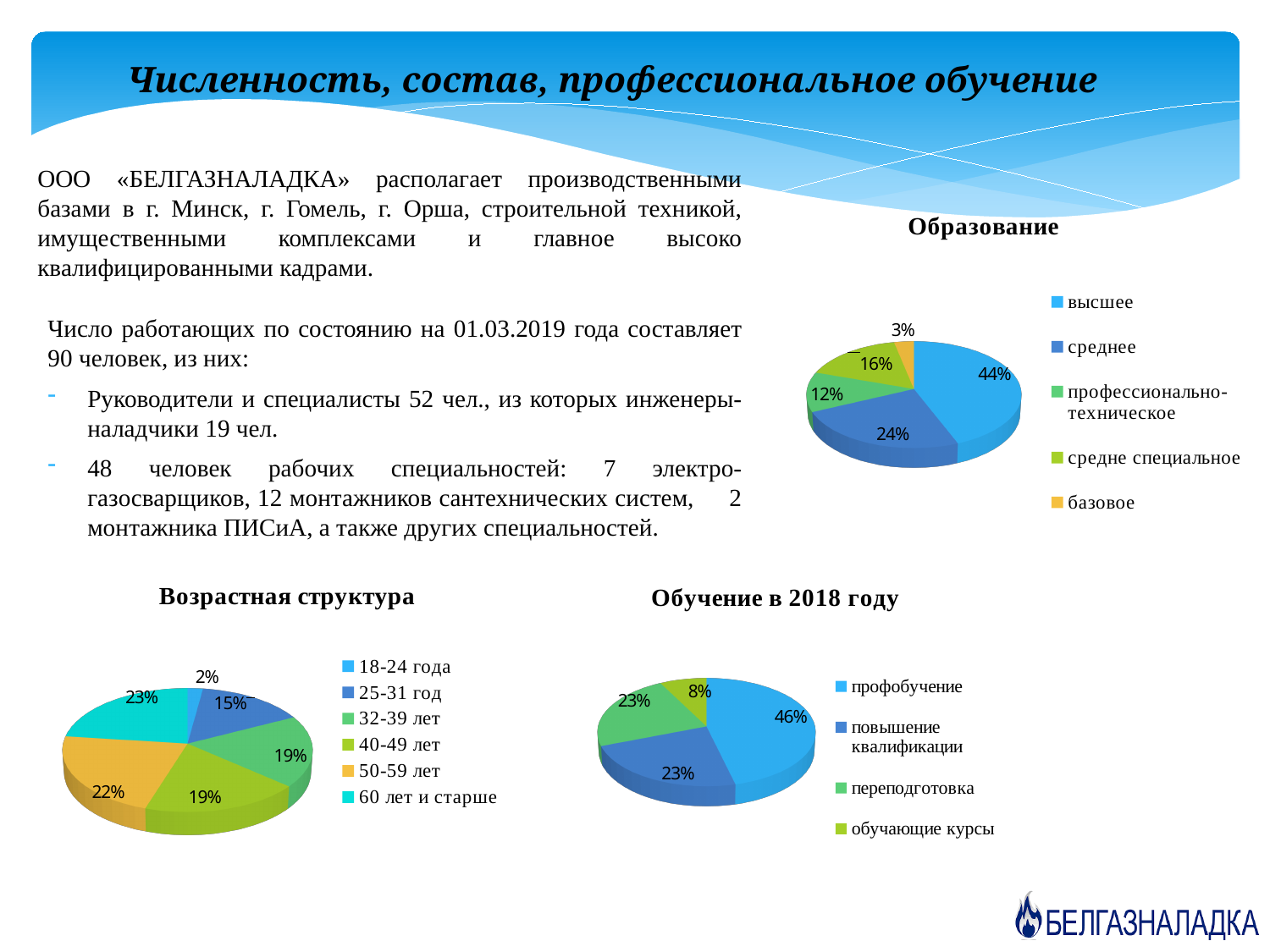
How many age groups are shown on the 'Возрастная структура' chart? 6 How many entries does the legend of the 'Образование' chart list? 5 On the 'Образование' chart, what is the difference between the 'среднее' share and the 'профессионально-техническое' share? 12% On the 'Возрастная структура' chart, what share is labelled for '50-59 лет'? 22% What kind of chart is 'Возрастная структура'? pie chart On the 'Образование' chart, what share is labelled for 'высшее'? 44% On the 'Образование' chart, which category has the smallest share? базовое On the 'Обучение в 2018 году' chart, what share is labelled for 'профобучение'? 46% On the 'Возрастная структура' chart, which age group has the largest share? 60 лет и старше On the 'Возрастная структура' chart, which age group has the smallest share? 18-24 года On the 'Обучение в 2018 году' chart, which is larger: 'повышение квалификации' or 'обучающие курсы'? повышение квалификации On the 'Обучение в 2018 году' chart, what is the difference between the 'профобучение' share and the 'переподготовка' share? 23%